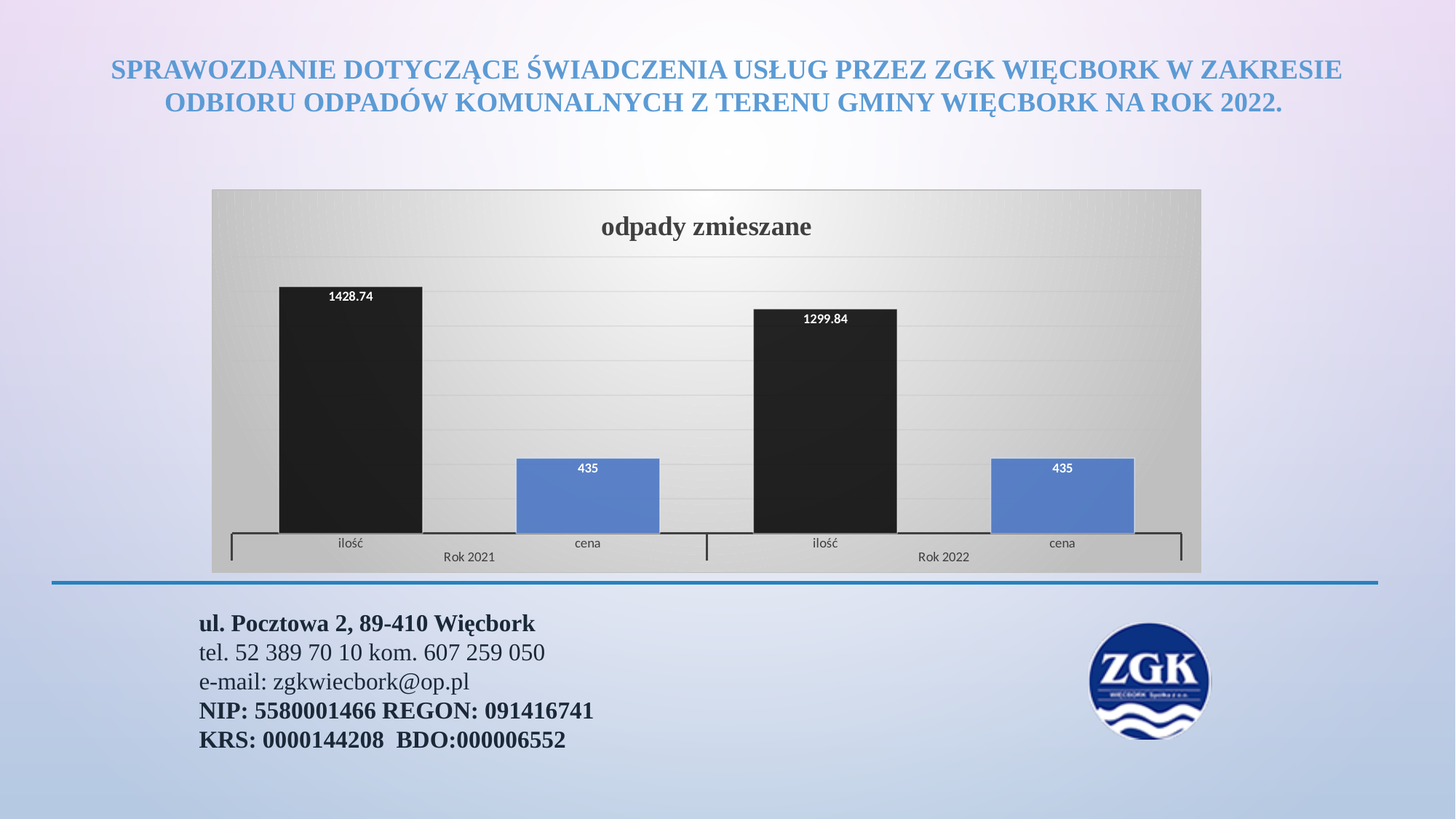
What is the value of ilość for Rok 2022? 1299.84 What is the difference between ilość for Rok 2021 and ilość for Rok 2022? 128.9 What is the value of cena for Rok 2022? 435 What is the title of the chart? odpady zmieszane Which is larger: ilość for Rok 2021 or ilość for Rok 2022? ilość for Rok 2021 What is the value of ilość for Rok 2021? 1428.74 Does the ilość value rise or fall from Rok 2021 to Rok 2022? fall Which bar has the highest value in the chart? ilość, Rok 2021 What is the difference between ilość and cena for Rok 2022? 864.84 How many bars are plotted in the chart? 4 What is the value of cena for Rok 2021? 435 What kind of chart is shown on the slide? bar chart